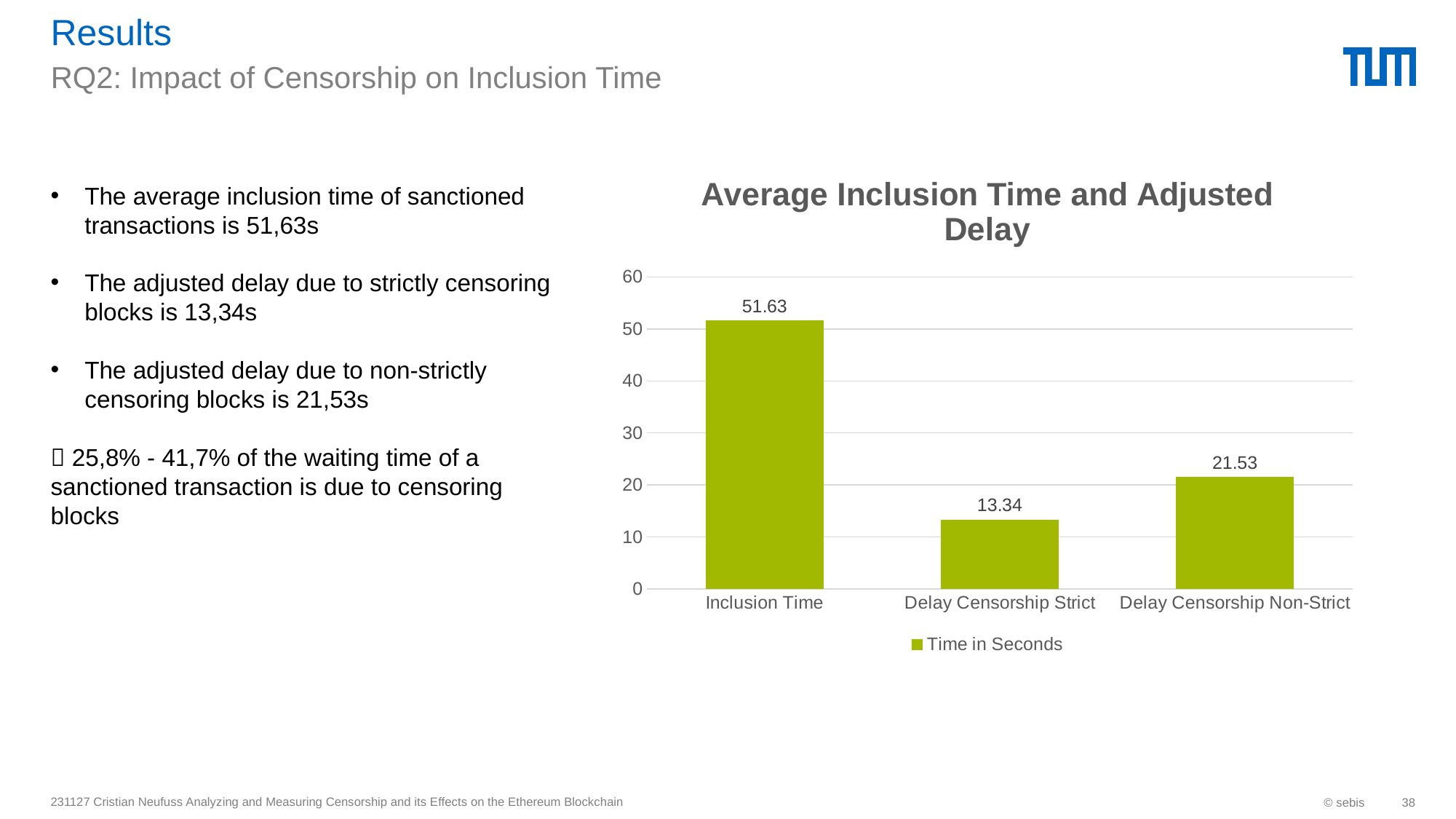
What is the value for Inclusion Time? 51.63 What is the title of the chart? Average Inclusion Time and Adjusted Delay What is the difference between the values for Delay Censorship Non-Strict and Delay Censorship Strict? 8.19 Which category has the lowest value? Delay Censorship Strict What is the value for Delay Censorship Non-Strict? 21.53 Which category has the highest value? Inclusion Time Which is larger, the value for Delay Censorship Strict or Delay Censorship Non-Strict? Delay Censorship Non-Strict What kind of chart is shown on the slide? bar chart Is the value for Inclusion Time greater or less than 50? greater What is the difference between the values for Inclusion Time and Delay Censorship Non-Strict? 30.1 What is the value for Delay Censorship Strict? 13.34 How many categories are shown on the x axis? 3